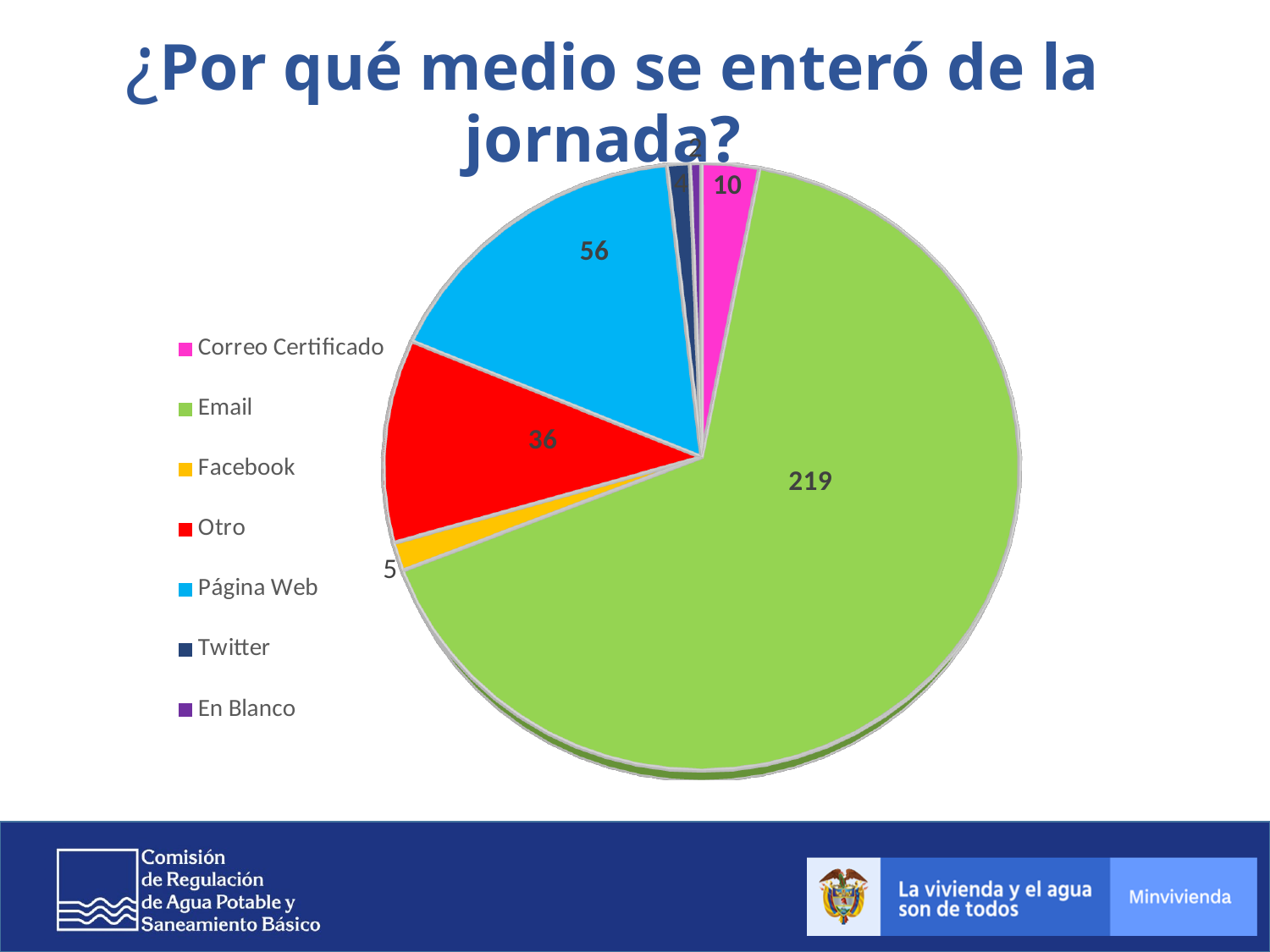
What is the difference between the values for Página Web and Otro? 20 What is the value for Facebook? 5 Which is larger, Otro or Página Web? Página Web What kind of chart is shown on the slide? pie chart What is the value for Otro? 36 What colour is the Email slice? green How many categories does the legend list? 7 What is the value for Página Web? 56 Which category has the largest slice of the pie? Email What is the value for Email? 219 What is the difference between the values for Email and Página Web? 163 What is the value for Correo Certificado? 10